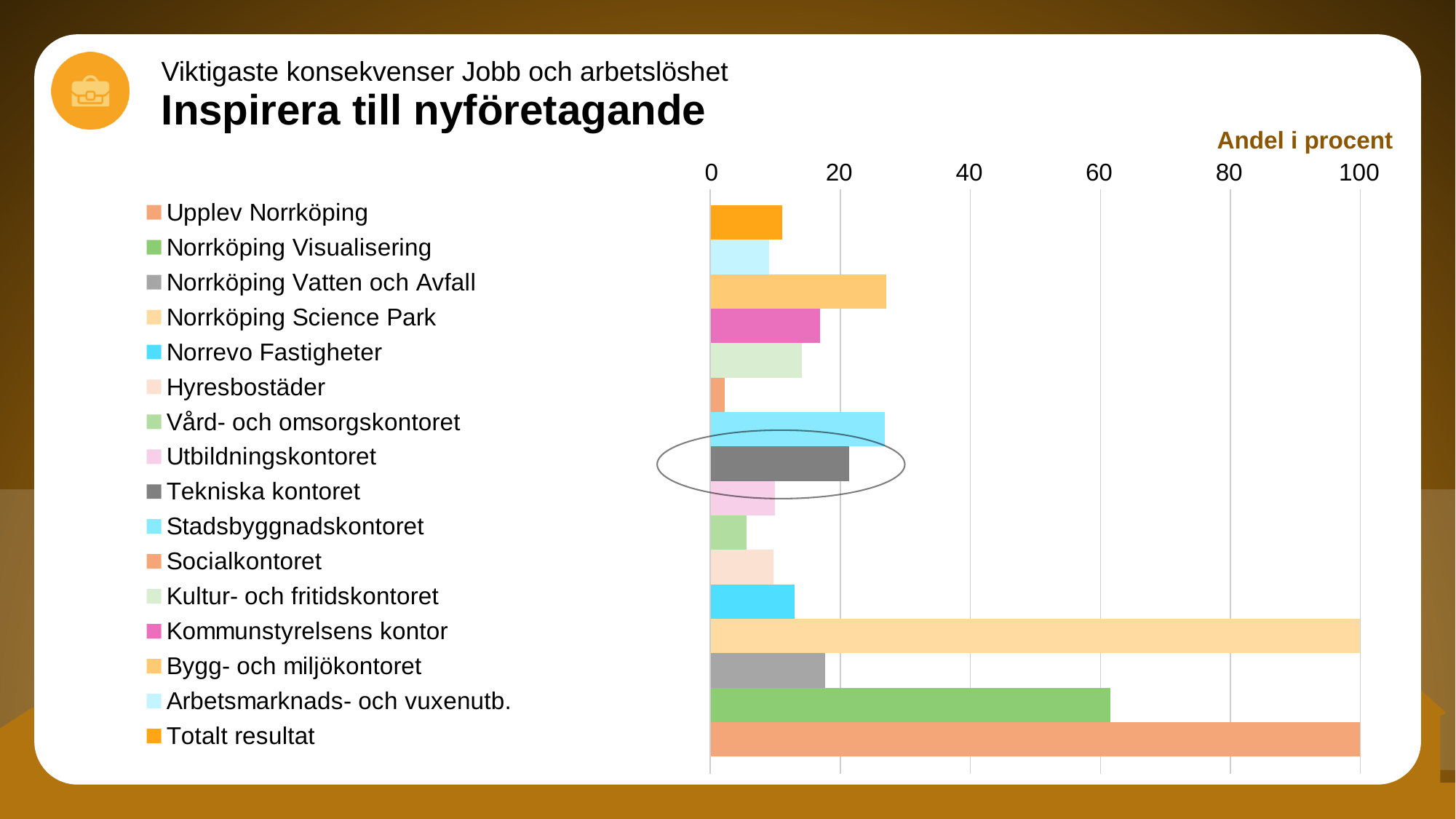
Which category has the lowest value in the chart? Socialkontoret Is the value for Totalt resultat greater or less than 20? less Is the value for Norrköping Visualisering greater or less than 80? less How many entries does the legend list? 16 What kind of chart is shown on the slide? bar chart Is the value for Bygg- och miljökontoret greater or less than 20? greater How many bars are plotted in the chart? 16 Which is larger, the value for Hyresbostäder or the value for Socialkontoret? Hyresbostäder Which is larger, the value for Norrköping Visualisering or the value for Bygg- och miljökontoret? Norrköping Visualisering What is the label shown above the value axis of the chart? Andel i procent